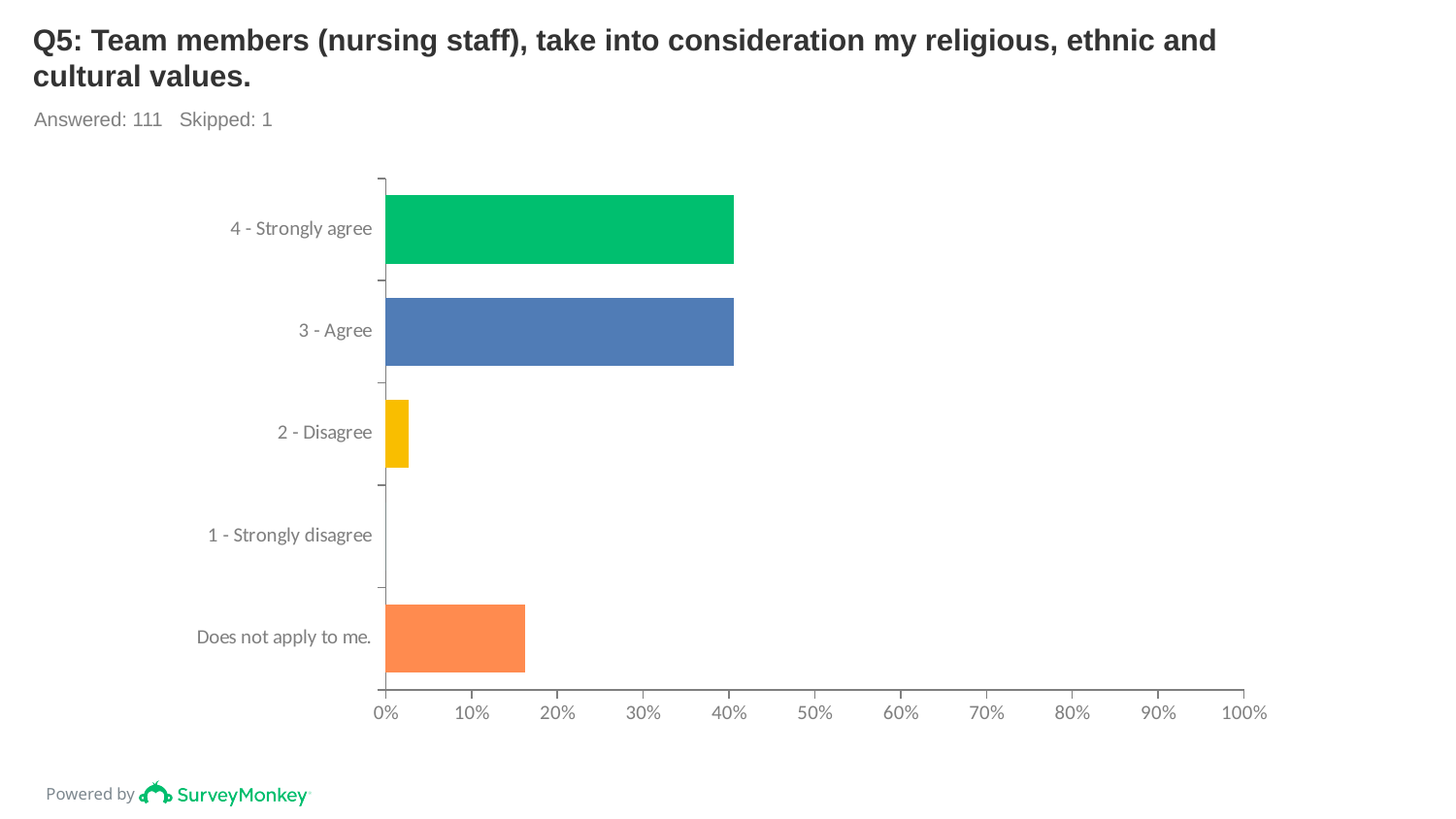
Which is larger, the value for "3 - Agree" or the value for "Does not apply to me."? 3 - Agree How many response categories are shown on the chart? 5 Which is larger, the value for "Does not apply to me." or the value for "2 - Disagree"? Does not apply to me. Is the value for "Does not apply to me." greater or less than 10%? greater Which response category has the lowest value? 1 - Strongly disagree Is the value for "Does not apply to me." greater or less than 20%? less Is the value for "2 - Disagree" greater or less than 10%? less What kind of chart is shown on the slide? bar chart How many respondents answered this question according to the slide? 111 What is the highest value shown on the x axis? 100%